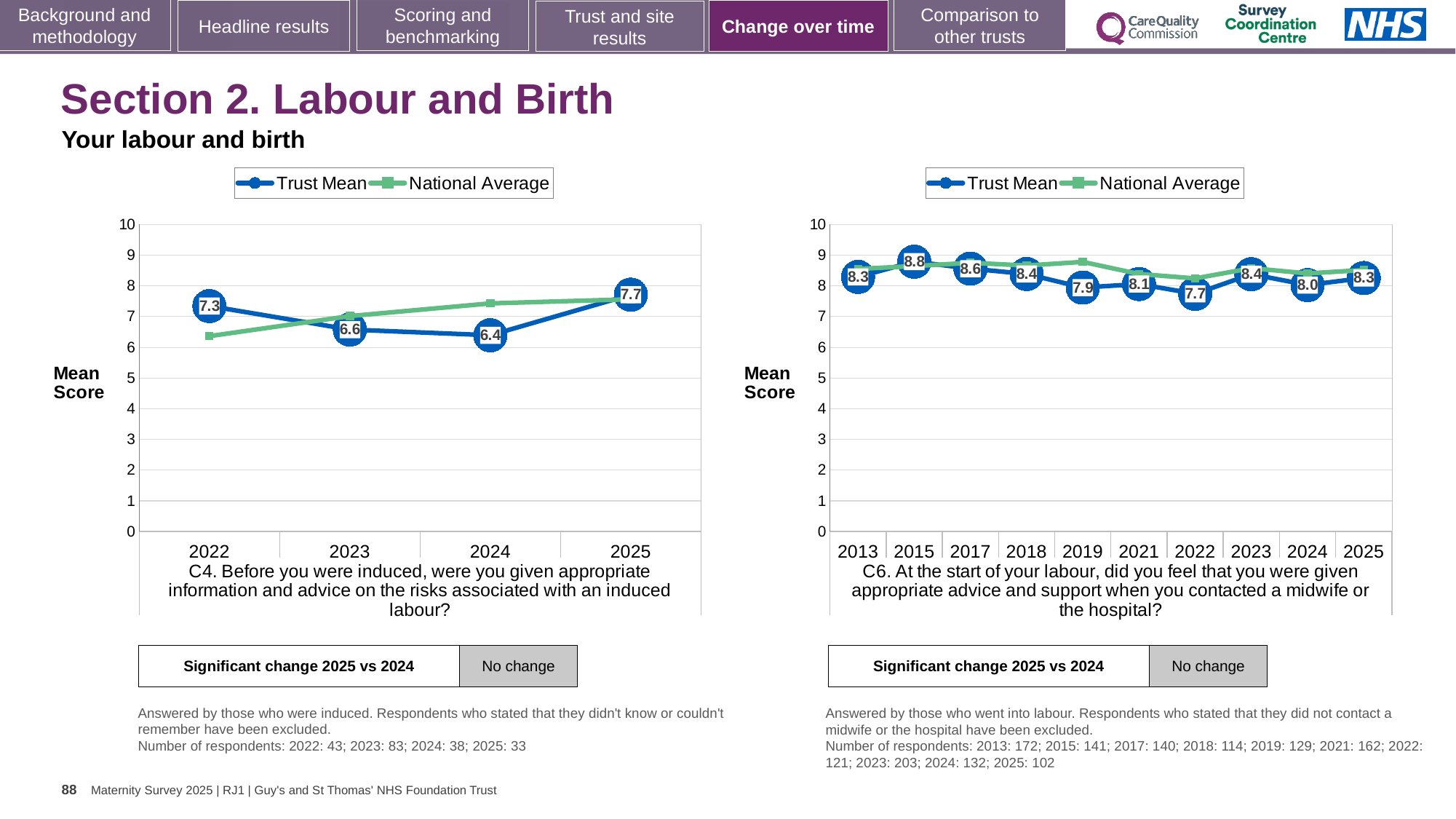
How many series does the legend of the C6 chart on the right list? 2 In the C4 chart on the left, how many years are shown on the x axis? 4 In the C4 chart on the left, which year has the lowest Trust Mean score? 2024 In the C6 chart on the right, how many years are plotted on the x axis? 10 In the C6 chart on the right, what is the Trust Mean score for 2022? 7.7 In the C4 chart on the left, what is the difference between the Trust Mean scores for 2025 and 2024? 1.3 What type of chart is the C4 chart on the left? Line chart In the C4 chart on the left, what is the Trust Mean score for 2024? 6.4 In the C6 chart on the right, which is larger, the Trust Mean score for 2019 or for 2021? 2021 In the C4 chart on the left, is the National Average value for 2022 greater or less than 7? less In the C6 chart on the right, which year has the highest Trust Mean score? 2015 In the C4 chart on the left, what is the Trust Mean score for 2025? 7.7